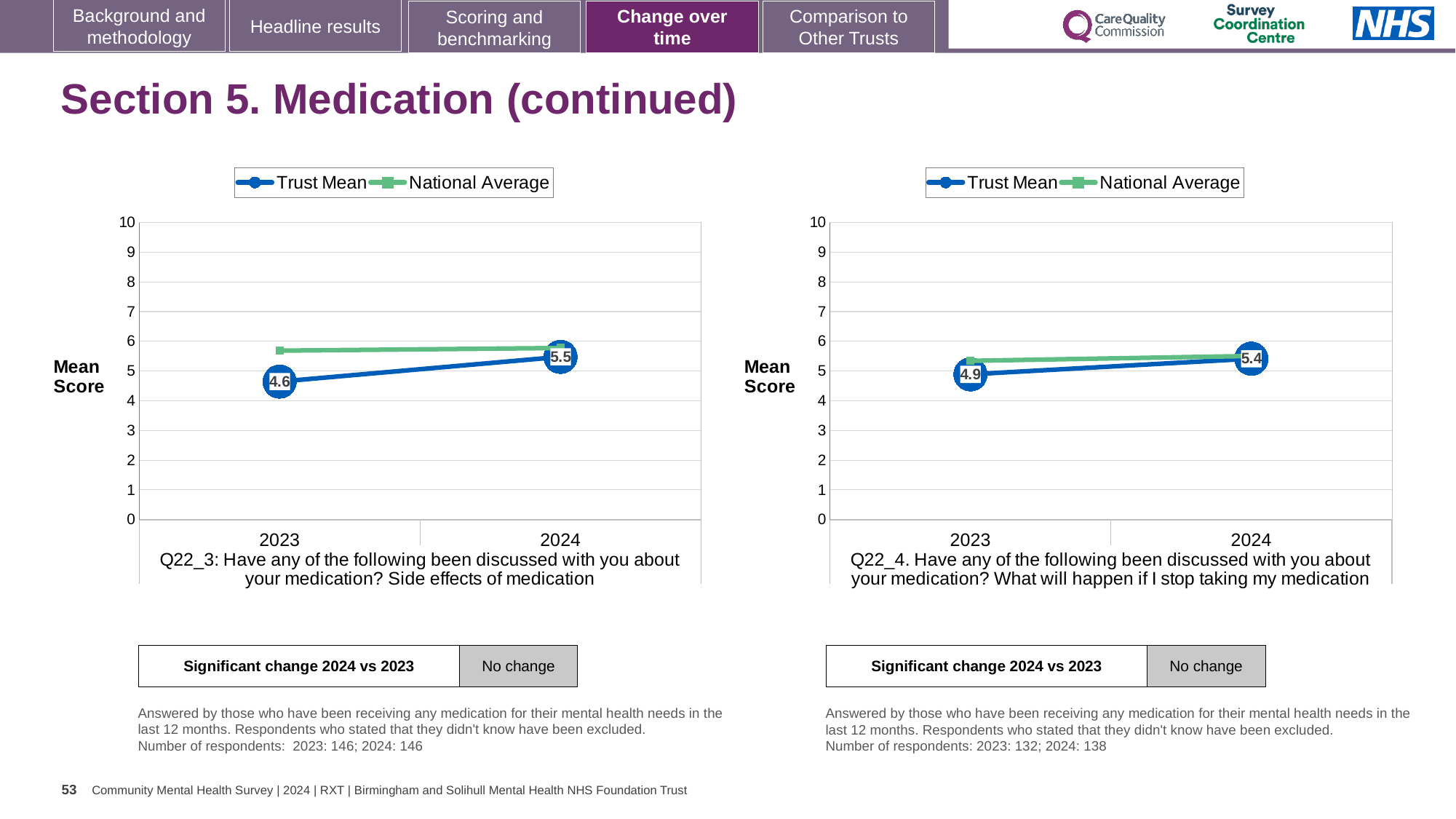
In the left chart (Q22_3), which is larger for 2023: the Trust Mean or the National Average? National Average In the right chart (Q22_4), what is the Trust Mean score for 2023? 4.9 How many series does the legend of the left chart (Q22_3) list? 2 In the right chart (Q22_4), what is the Trust Mean score for 2024? 5.4 In the left chart (Q22_3), what is the Trust Mean score for 2024? 5.5 In the left chart (Q22_3), is the National Average for 2023 greater or less than 5? greater In the left chart (Q22_3), by how much did the Trust Mean change from 2023 to 2024? 0.9 In the left chart (Q22_3), what is the Trust Mean score for 2023? 4.6 In the right chart (Q22_4), by how much did the Trust Mean change from 2023 to 2024? 0.5 What kind of chart is the right chart (Q22_4)? line chart In the left chart (Q22_3), does the Trust Mean rise or fall from 2023 to 2024? rise How many years are plotted on the x axis of the right chart (Q22_4)? 2